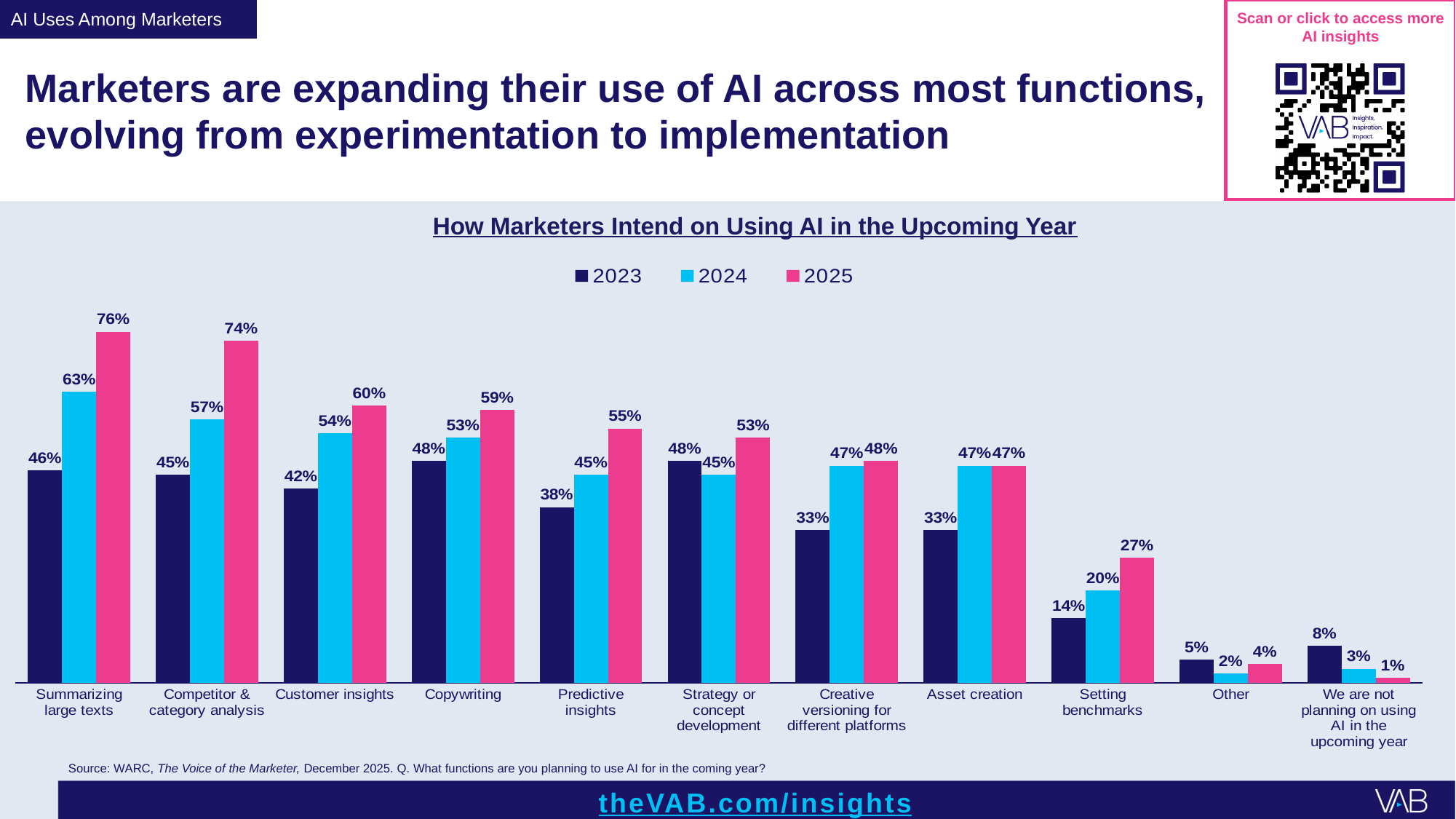
What is the 2025 value for Summarizing large texts? 76% How many series does the legend list? 3 Which category has the highest 2025 value? Summarizing large texts What is the 2024 value for Setting benchmarks? 20% What is the 2023 value for Predictive insights? 38% For Strategy or concept development, which is larger: the 2023 value or the 2024 value? 2023 Which category has the lowest 2025 value? We are not planning on using AI in the upcoming year How many categories are shown on the x axis? 11 What is the difference between the 2025 and 2023 values for Competitor & category analysis? 29 percentage points What is the title of the chart? How Marketers Intend on Using AI in the Upcoming Year For Asset creation, how do the 2024 and 2025 values compare? They are equal at 47% What kind of chart is shown on the slide? Bar chart